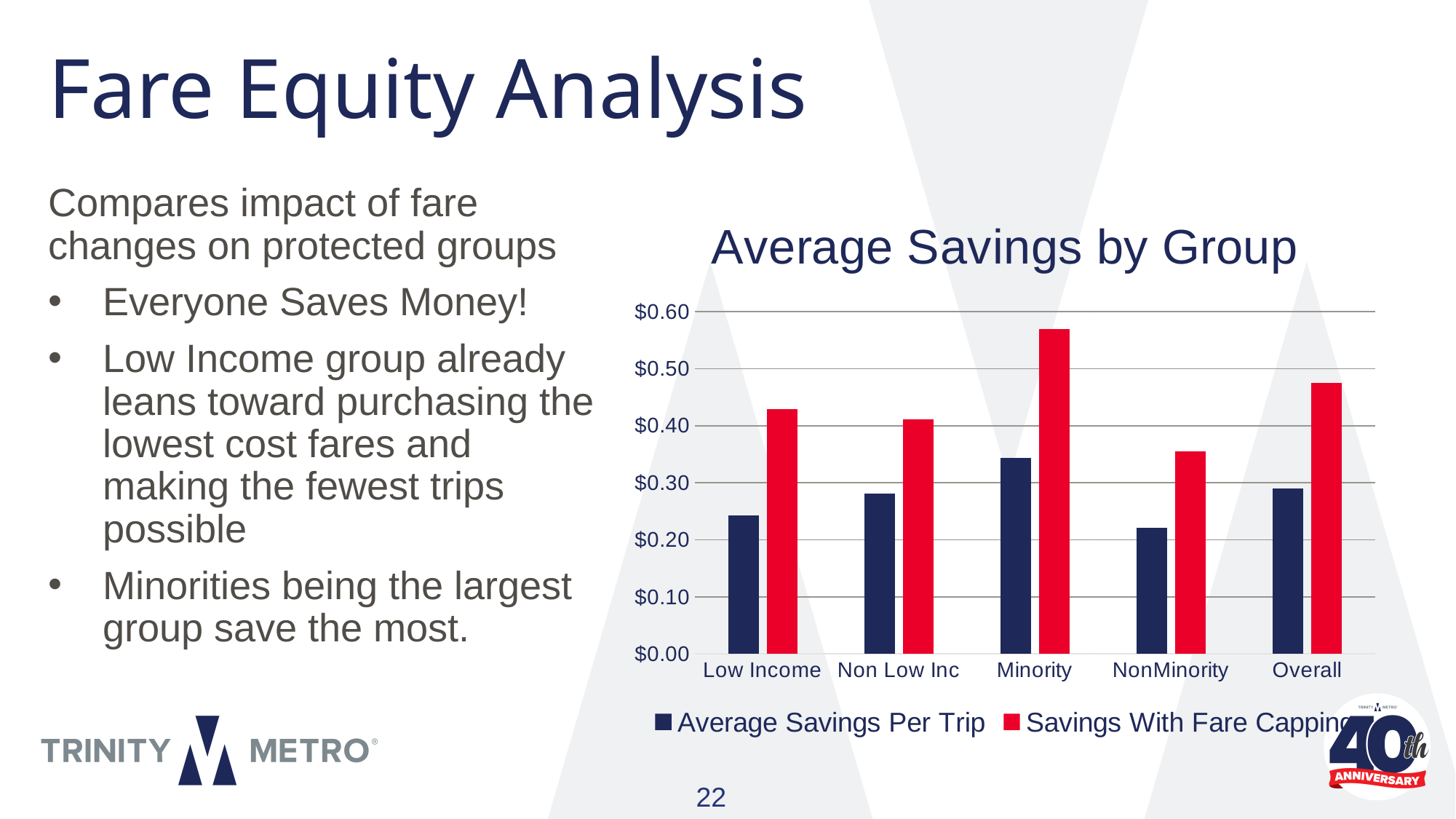
Is the Savings With Fare Capping value for Overall greater or less than $0.40? greater Which group has the highest value for Average Savings Per Trip? Minority Is the Savings With Fare Capping value for Minority greater or less than $0.50? greater Which is larger: Savings With Fare Capping for Minority or for Overall? Minority What is the title of the chart? Average Savings by Group Is the Average Savings Per Trip value for Low Income greater or less than $0.30? less How many groups are shown on the x axis of the chart? 5 How many series does the chart legend list? 2 Which group has the lowest value for Savings With Fare Capping? NonMinority What type of chart is shown on the slide? bar chart Which colour represents the Savings With Fare Capping series in the chart? red Which group has the highest value for Savings With Fare Capping? Minority